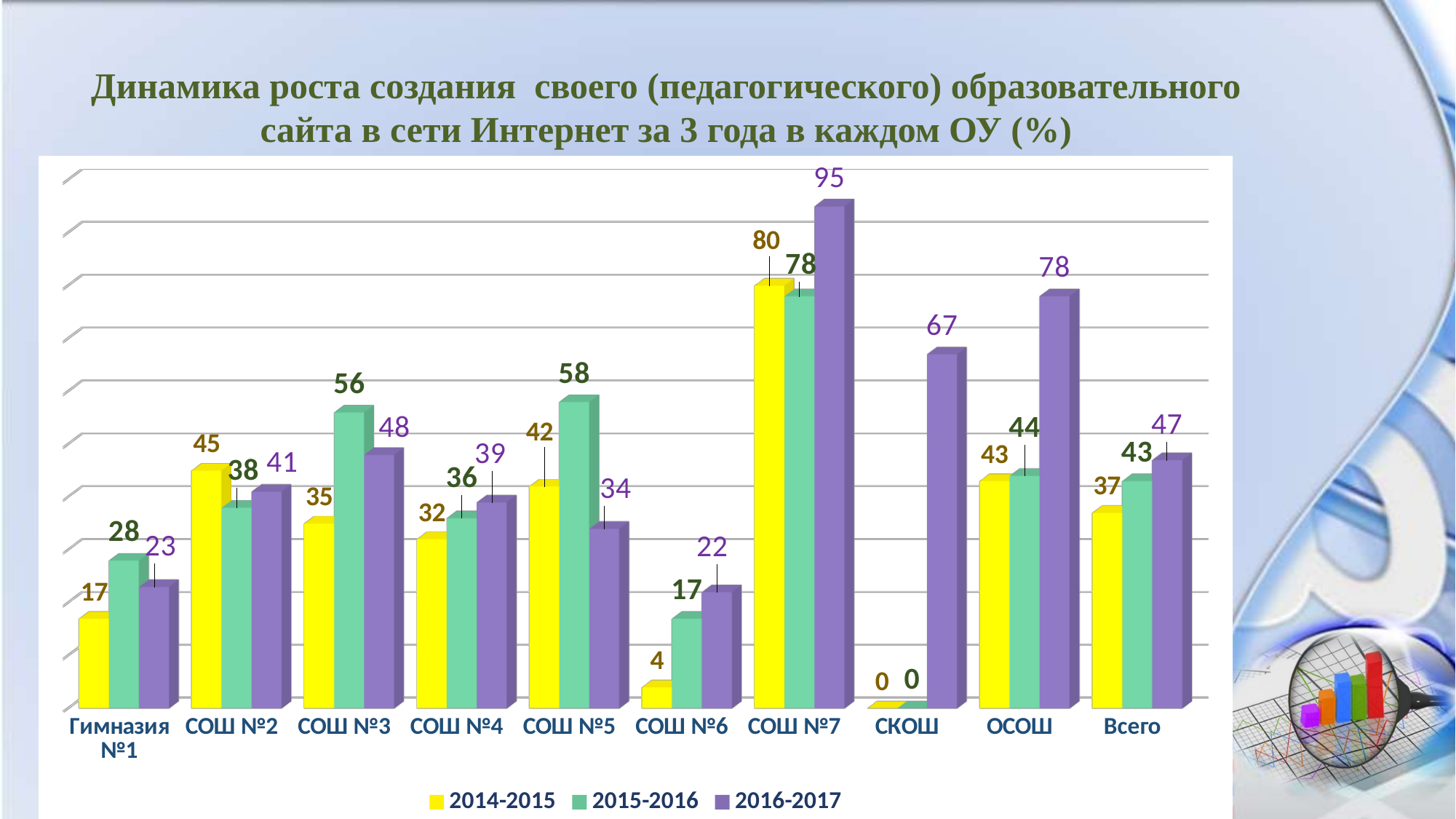
Which is larger for СОШ №5: the 2015-2016 value or the 2016-2017 value? 2015-2016 Do the values for Всего rise or fall from 2014-2015 to 2016-2017? Rise Which category has the lowest value in the 2016-2017 series? СОШ №6 Which category has the highest value in the 2015-2016 series? СОШ №7 What is the value for СОШ №7 in the 2016-2017 series? 95 Which colour represents the 2014-2015 series in the legend? Yellow What is the value for СКОШ in the 2014-2015 series? 0 What is the value for Всего in the 2015-2016 series? 43 How many categories are shown on the x axis? 10 What is the difference between the 2016-2017 and 2014-2015 values for ОСОШ? 35 How many series does the legend list? 3 What kind of chart is shown on the slide? Bar chart